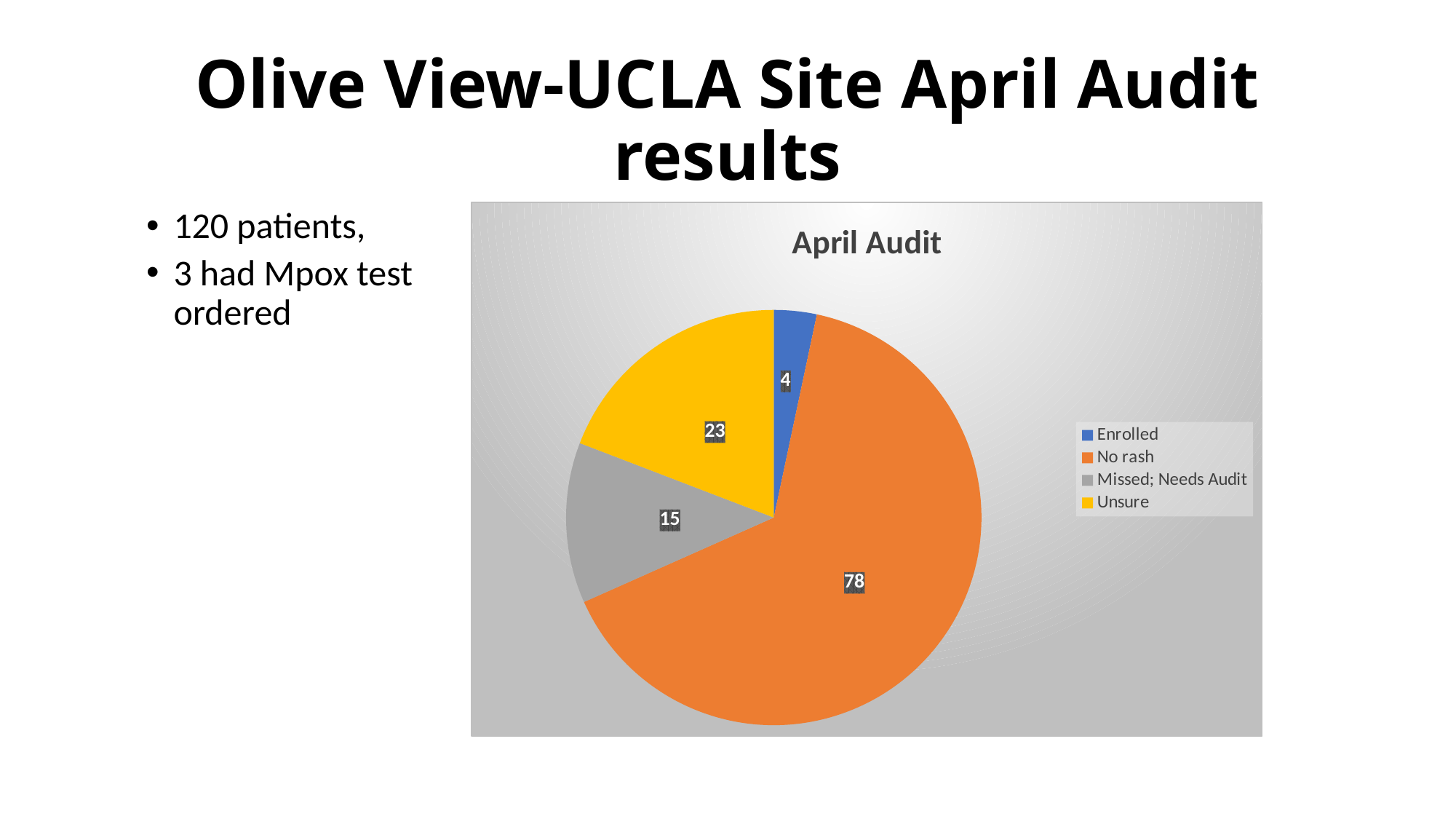
Which category has the largest slice in the April Audit pie chart? No rash What kind of chart is shown on the slide? Pie chart What colour is the Unsure slice in the April Audit pie chart? Yellow How many slices does the April Audit pie chart have? 4 What share of the April Audit pie does the No rash slice represent? 65% Which is larger in the April Audit pie chart, Unsure or Missed; Needs Audit? Unsure What is the value for Enrolled in the April Audit pie chart? 4 What is the value for No rash in the April Audit pie chart? 78 What is the value for Missed; Needs Audit in the April Audit pie chart? 15 What is the difference between the No rash and Unsure values in the April Audit pie chart? 55 Which category has the smallest slice in the April Audit pie chart? Enrolled What is the value for Unsure in the April Audit pie chart? 23